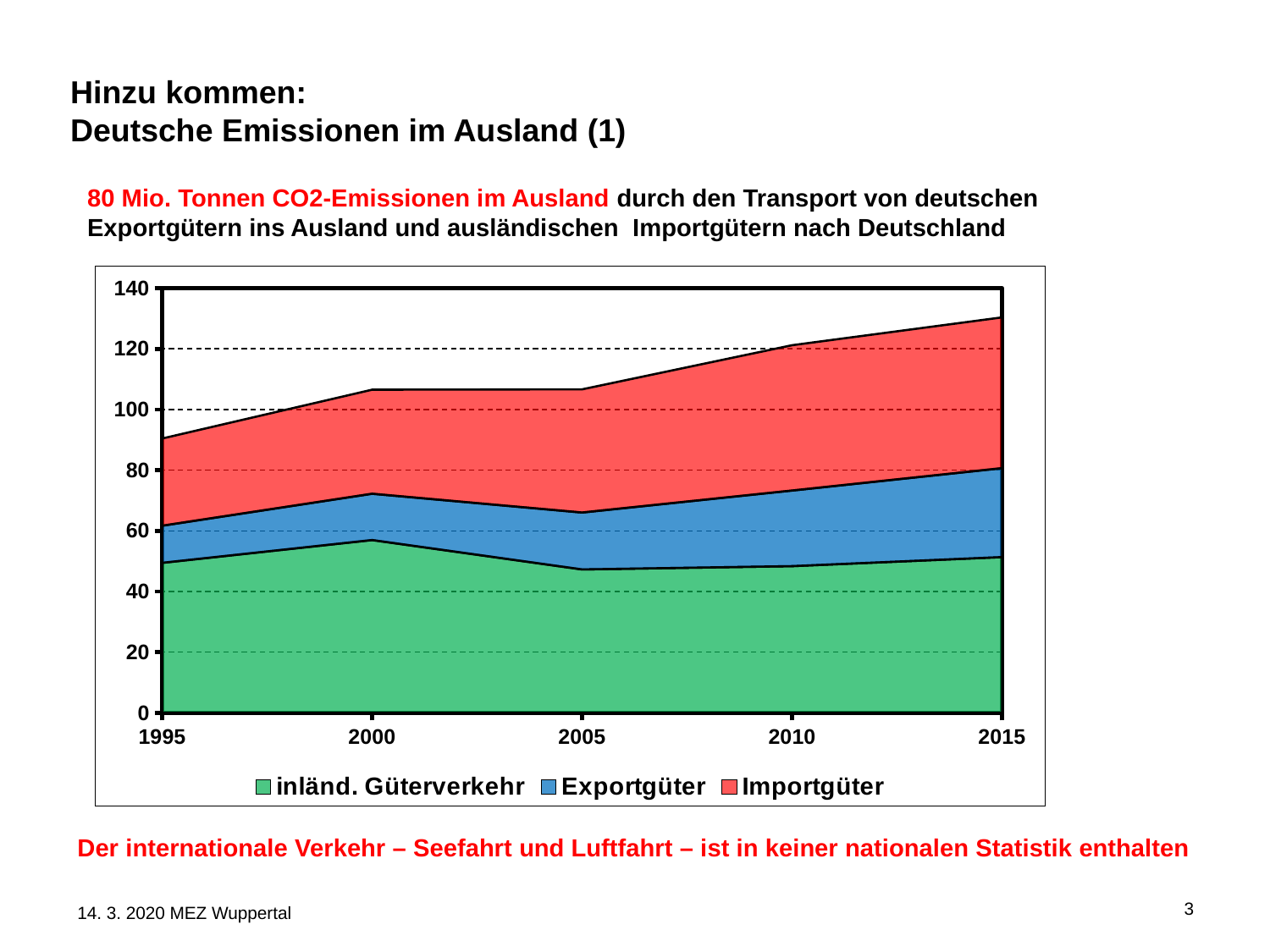
Is the total stacked value for 2015 greater or less than 120? greater Is the value for inländ. Güterverkehr in 2005 greater or less than 60? less In which year is the total stacked value highest? 2015 What kind of chart is shown on the slide? Stacked area chart How many years are plotted along the x axis of the chart? 5 Is the total stacked value for 1995 greater or less than 100? less Which series is shown in red in the chart? Importgüter In which year is the total stacked value lowest? 1995 Does the total stacked value rise or fall from 1995 to 2015? rise Which series is shown in green in the chart? inländ. Güterverkehr How many series does the chart's legend list? 3